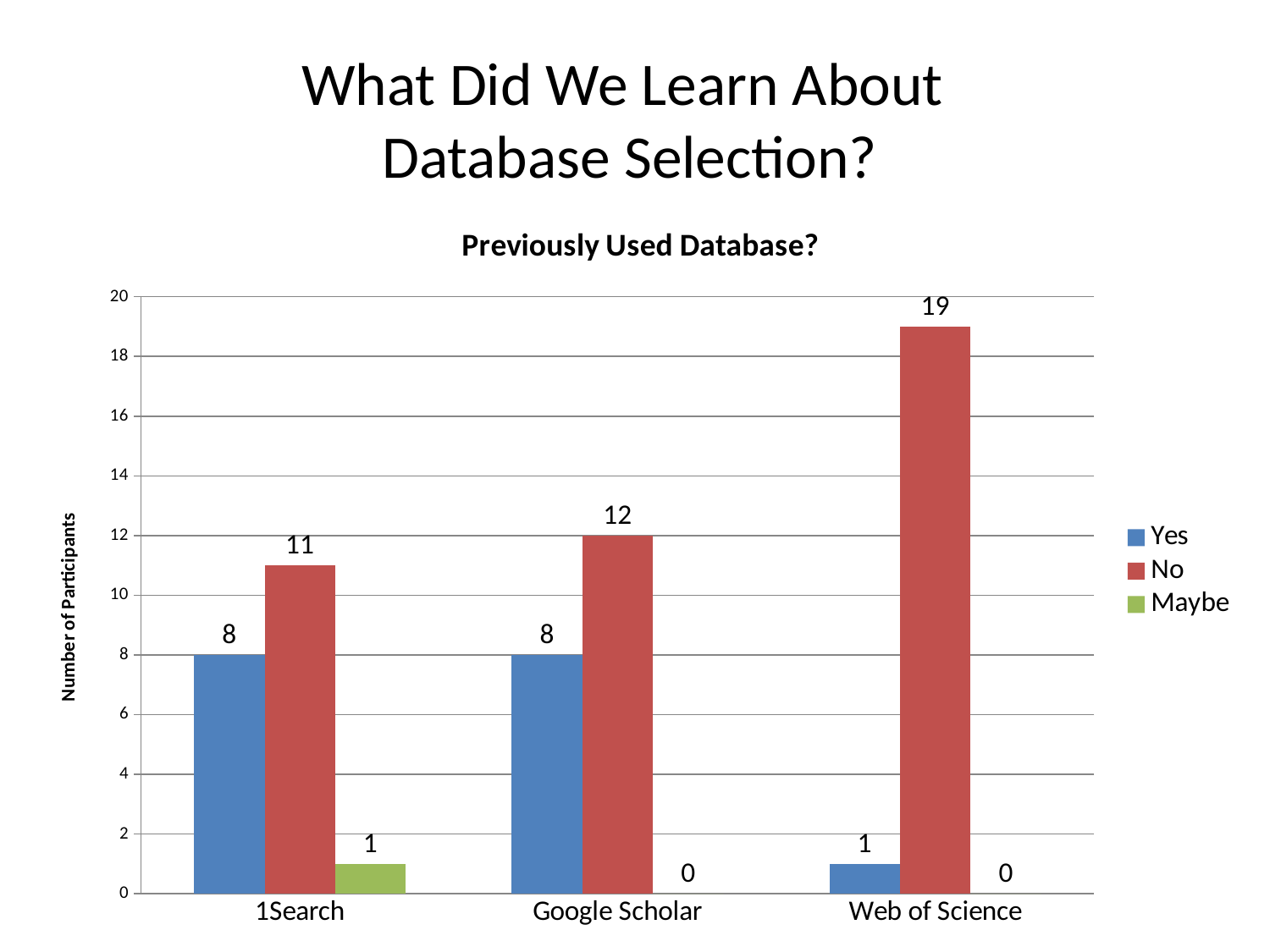
How many series does the legend list? 3 What is the value for "Yes" for Web of Science? 1 What is the title of the chart? Previously Used Database? What kind of chart is shown? Bar chart What is the value for "Maybe" for 1Search? 1 What is the value for "Yes" for Google Scholar? 8 Which database has the lowest "Yes" value? Web of Science What is the difference between the "No" values for Web of Science and Google Scholar? 7 Which is larger for 1Search: the "Yes" value or the "No" value? No How many databases (categories) are shown on the x axis? 3 Which database has the highest "No" value? Web of Science What is the value for "No" for Web of Science? 19